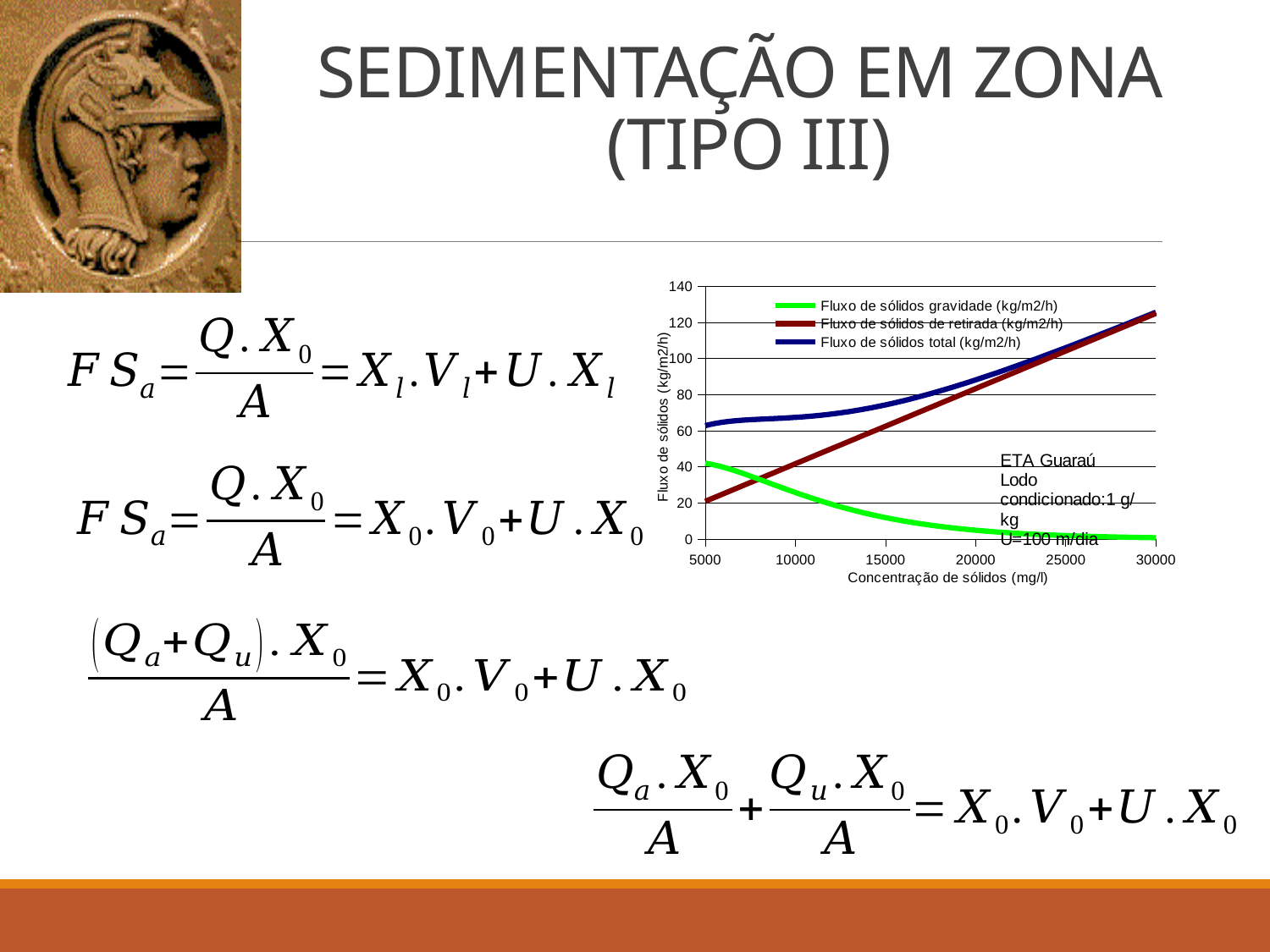
At a concentration of 30000 mg/l, which is larger: Fluxo de sólidos de retirada or Fluxo de sólidos gravidade? Fluxo de sólidos de retirada Is the value of Fluxo de sólidos de retirada at a concentration of 30000 mg/l greater or less than 100? greater Which series is shown in green in the chart legend? Fluxo de sólidos gravidade (kg/m2/h) At a concentration of 5000 mg/l, which is larger: Fluxo de sólidos total or Fluxo de sólidos gravidade? Fluxo de sólidos total Does the Fluxo de sólidos de retirada series rise or fall as the concentration increases along the x axis? rise What kind of chart is shown on the slide? line chart Is the value of Fluxo de sólidos gravidade at a concentration of 30000 mg/l greater or less than 20? less Does the Fluxo de sólidos total series rise or fall as the concentration increases along the x axis? rise Is the value of Fluxo de sólidos total at a concentration of 5000 mg/l greater or less than 60? greater Does the Fluxo de sólidos gravidade series rise or fall as the concentration increases along the x axis? fall What is the title of the x axis of the chart? Concentração de sólidos (mg/l) How many series does the chart legend list? 3